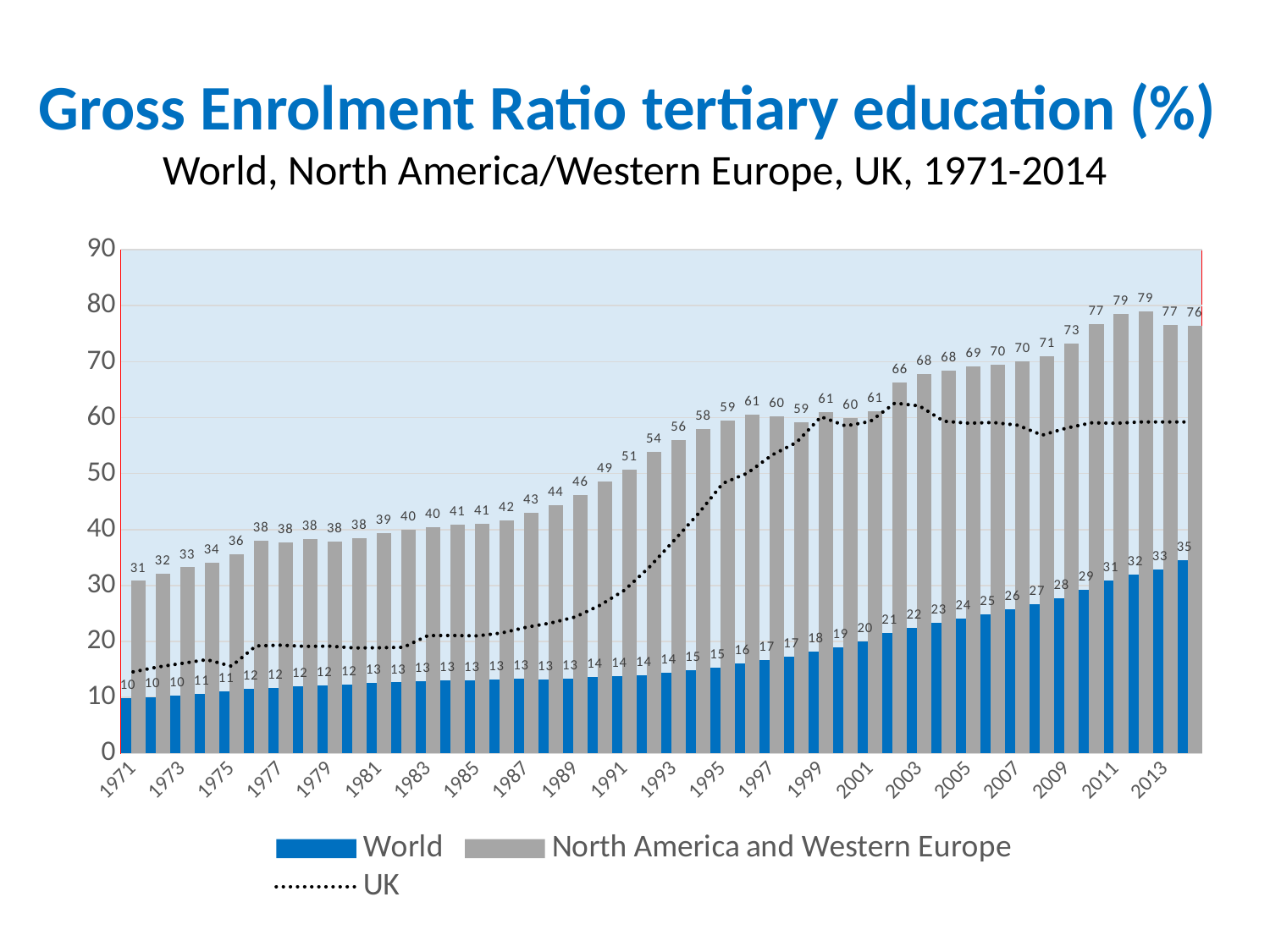
Is the UK value for 1971 greater or less than 20? less Is the UK value for 1995 greater or less than 40? greater What is the difference between the North America and Western Europe value and the World value in 2014? 41 What is the lowest value shown for the World series? 10 Which is larger in 2002: the North America and Western Europe value or the World value? North America and Western Europe What is the World value for 2014? 35 How many series does the legend list? 3 What is the title of the chart? Gross Enrolment Ratio tertiary education (%) What is the World value for 1971? 10 What is the highest value reached by the North America and Western Europe series? 79 Does the World series rise or fall from 1971 to 2014? rise What is the North America and Western Europe value for 2014? 76